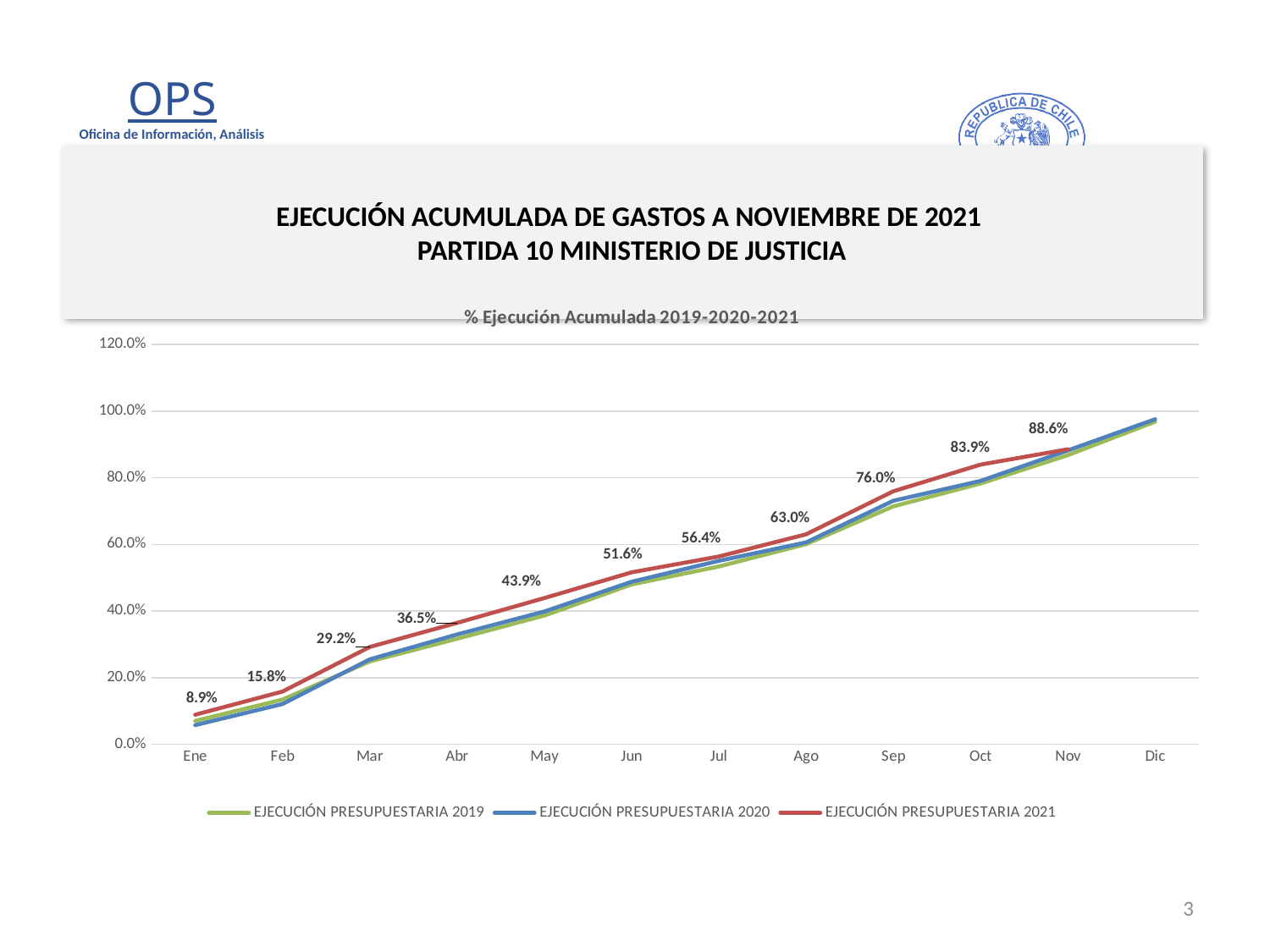
What is the difference between the EJECUCIÓN PRESUPUESTARIA 2021 values for Mar and Feb? 13.4% What is the value for EJECUCIÓN PRESUPUESTARIA 2021 in Sep? 76.0% How many months are shown on the x axis? 12 What kind of chart is shown on the slide? Line chart What is the title of the chart? % Ejecución Acumulada 2019-2020-2021 What is the value for EJECUCIÓN PRESUPUESTARIA 2021 in Jun? 51.6% Is the value for EJECUCIÓN PRESUPUESTARIA 2020 in Dic greater or less than 80.0%? greater How many series does the legend list? 3 What is the value for EJECUCIÓN PRESUPUESTARIA 2021 in Ene? 8.9% What is the value for EJECUCIÓN PRESUPUESTARIA 2021 in Nov? 88.6% What is the difference between the EJECUCIÓN PRESUPUESTARIA 2021 values for Oct and Sep? 7.9% Do the values for EJECUCIÓN PRESUPUESTARIA 2021 rise or fall from Ene to Nov? Rise